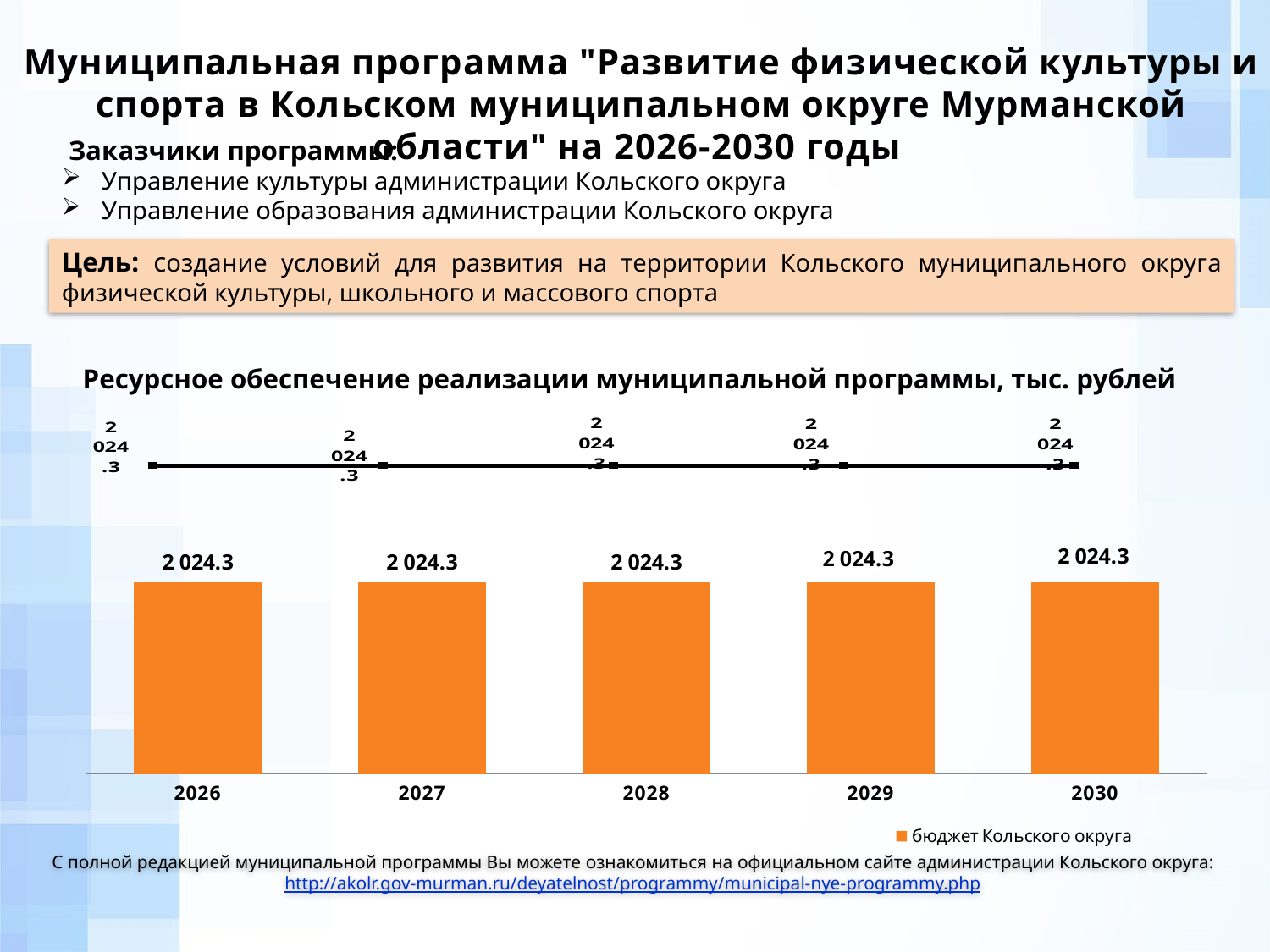
Do the bar values rise, fall or stay the same from 2026 to 2030? stay the same What is the difference between the values for 2030 and 2026? 0 What is the title of the chart? Ресурсное обеспечение реализации муниципальной программы, тыс. рублей How many years (categories) are shown on the x axis of the chart? 5 What is the value for 2027 in the bar chart? 2 024.3 What is the value for 2028 in the bar chart? 2 024.3 What is the value for 2026 in the bar chart? 2 024.3 What is the value for 2030 in the bar chart? 2 024.3 How many series does the chart legend list? 1 What is the value for 2029 in the bar chart? 2 024.3 What kind of chart is shown on the slide? bar chart What series name is listed in the chart legend? бюджет Кольского округа